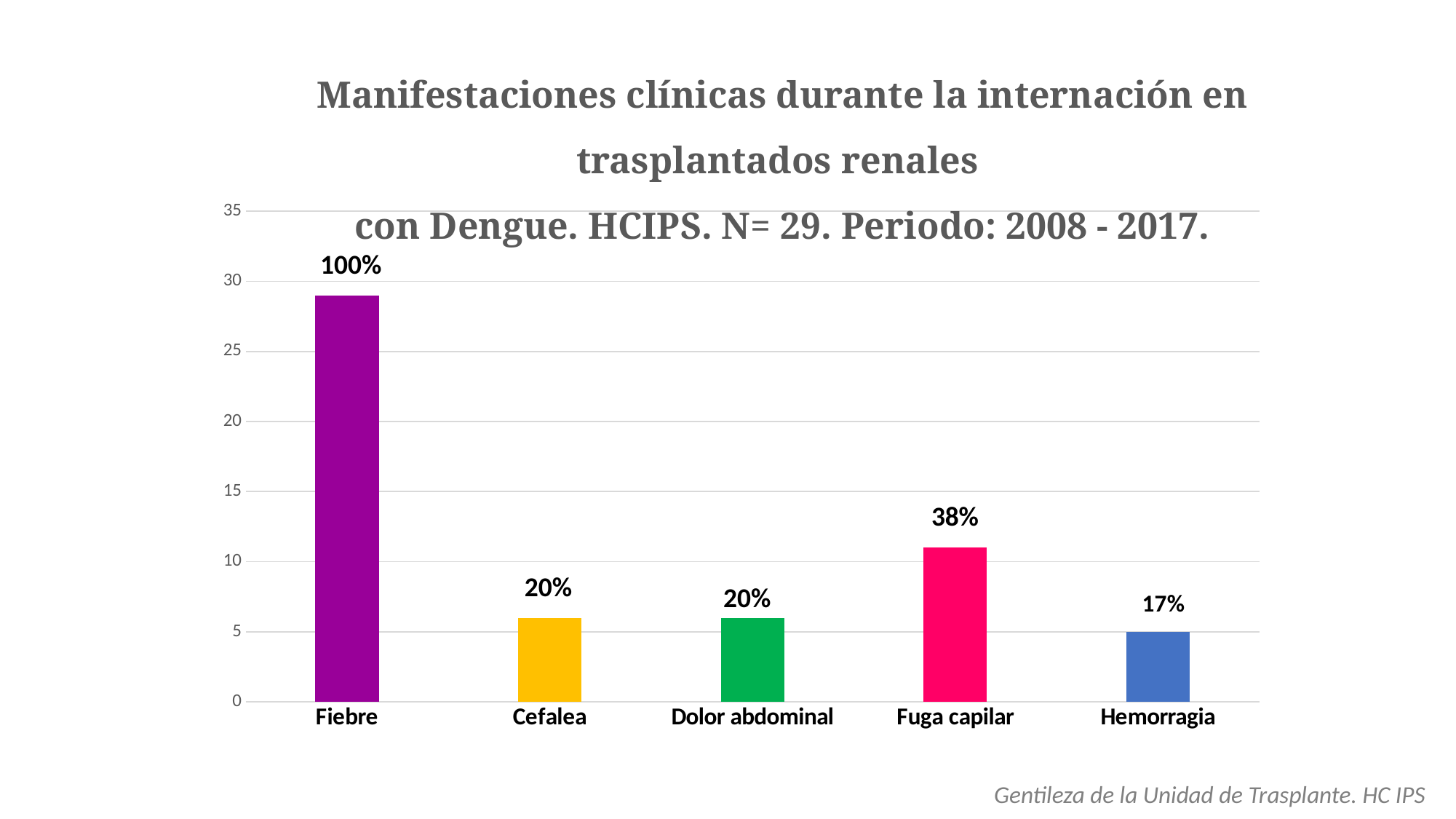
What type of chart is shown on the slide? Bar chart What percentage is shown for Cefalea? 20% What percentage is shown for Hemorragia? 17% Is the bar for Fiebre greater or less than 25 on the vertical axis? greater What is the data label shown for Fiebre? 100% Which clinical manifestation has the highest value? Fiebre Which is larger, the value for Fuga capilar or the value for Hemorragia? Fuga capilar What percentage is shown for Fuga capilar? 38% Is the bar for Dolor abdominal greater or less than 10 on the vertical axis? less How many clinical manifestations are shown on the x axis? 5 Which clinical manifestation has the lowest value? Hemorragia What is the difference in percentage points between Fiebre and Fuga capilar? 62%